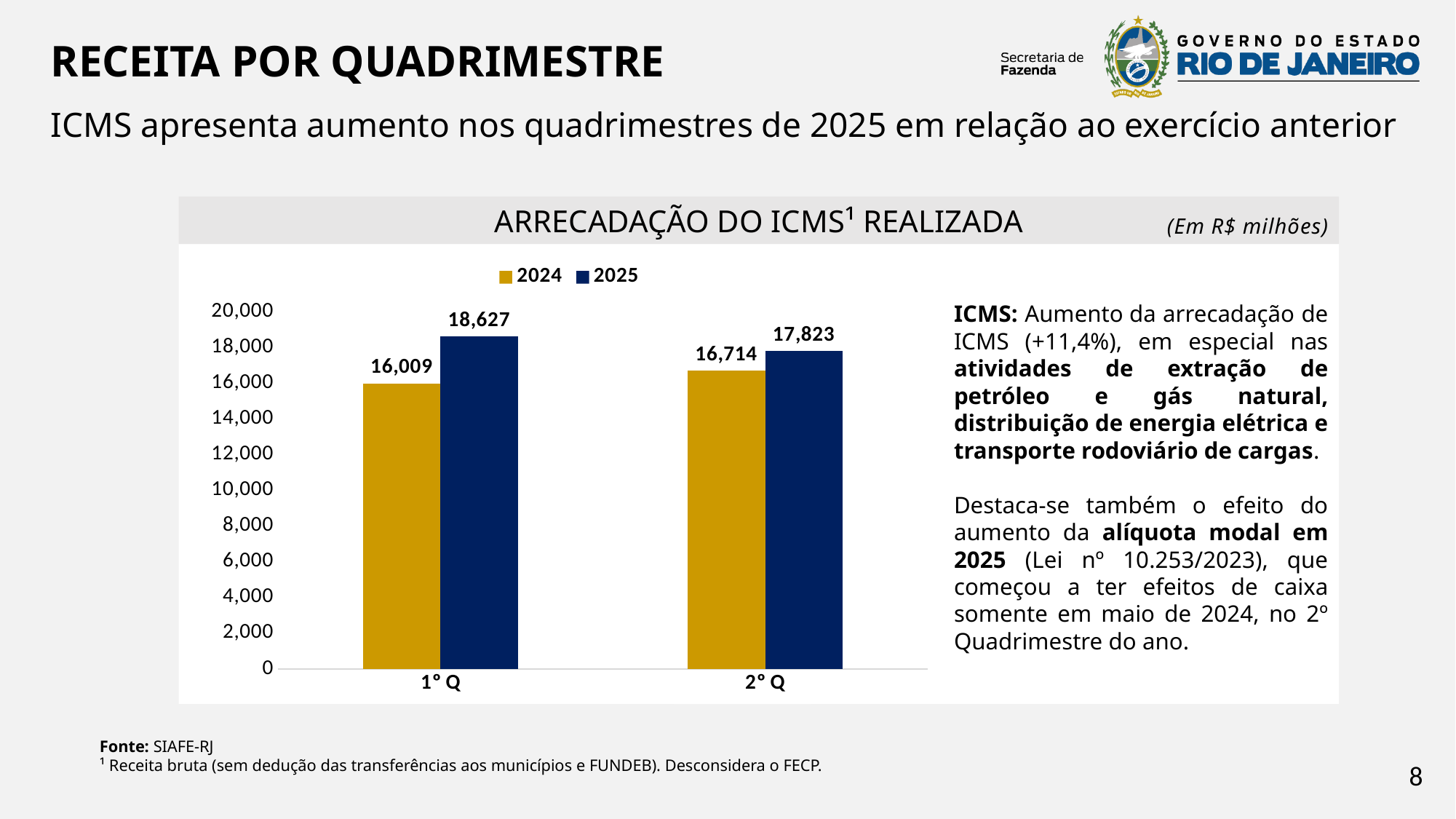
What is the 2025 value for 1° Q? 18,627 What kind of chart is shown? Bar chart What is the title of the chart? ARRECADAÇÃO DO ICMS¹ REALIZADA What is the 2025 value for 2° Q? 17,823 What is the 2024 value for 2° Q? 16,714 What is the 2024 value for 1° Q? 16,009 Which is larger for 2° Q, the 2024 value or the 2025 value? 2025 Which quadrimestre has the lowest 2024 value? 1° Q What is the difference between the 2025 and 2024 values for 1° Q? 2,618 What is the difference between the 2025 and 2024 values for 2° Q? 1,109 Which quadrimestre has the highest 2025 value? 1° Q How many series does the legend list? 2